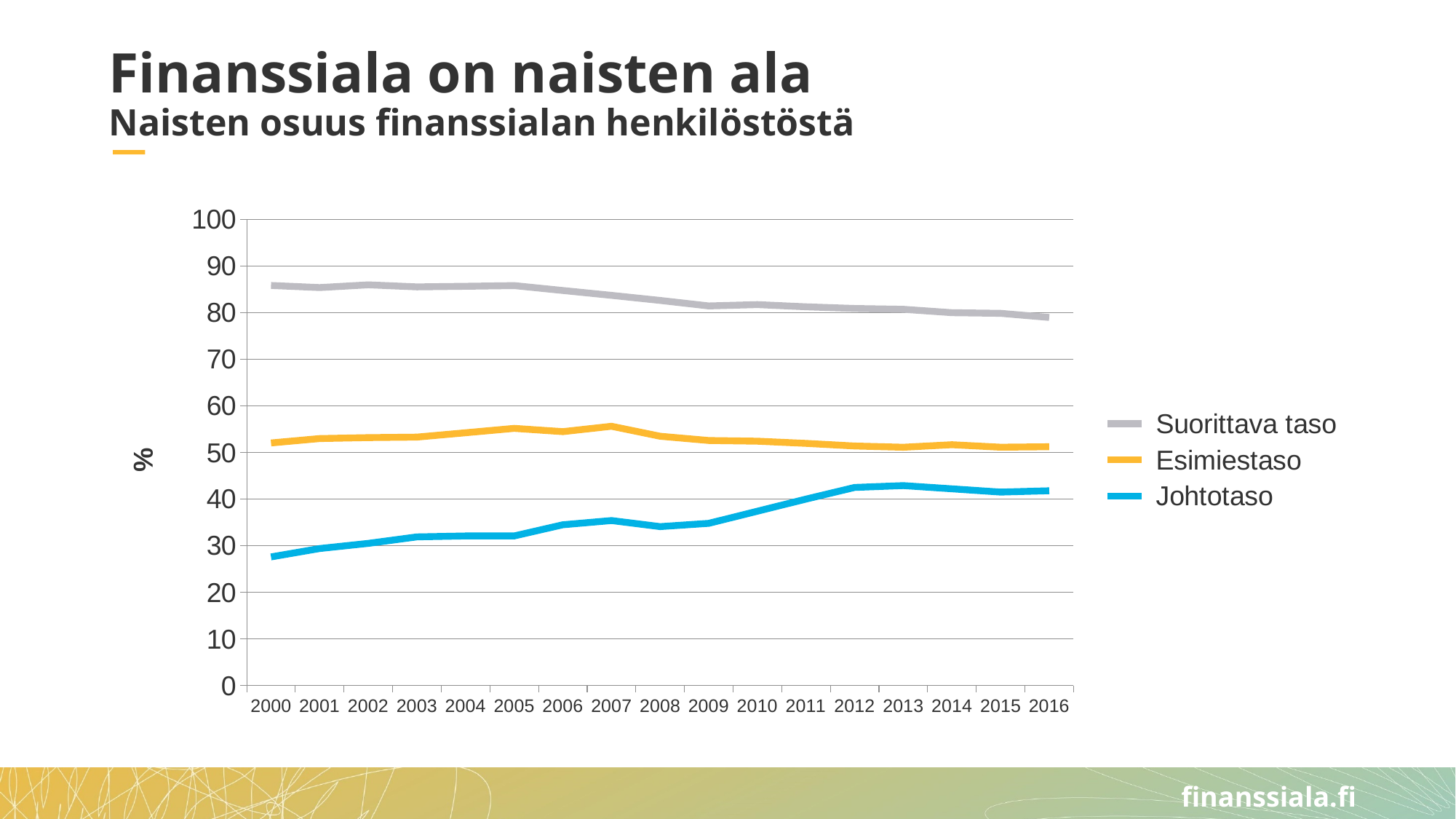
Which series has the higher value in 2016, Suorittava taso or Johtotaso? Suorittava taso What is the label on the y axis? % How many series does the legend list? 3 Is the value for Johtotaso in 2013 greater or less than 40? greater Is the value for Johtotaso in 2000 greater or less than 30? less What kind of chart is shown on the slide? line chart Which series has the highest values across all years? Suorittava taso Does the Suorittava taso line rise or fall from 2000 to 2016? fall Is the value for Esimiestaso in 2007 greater or less than 50? greater Does the Johtotaso line rise or fall from 2000 to 2016? rise How many years are shown on the x axis? 17